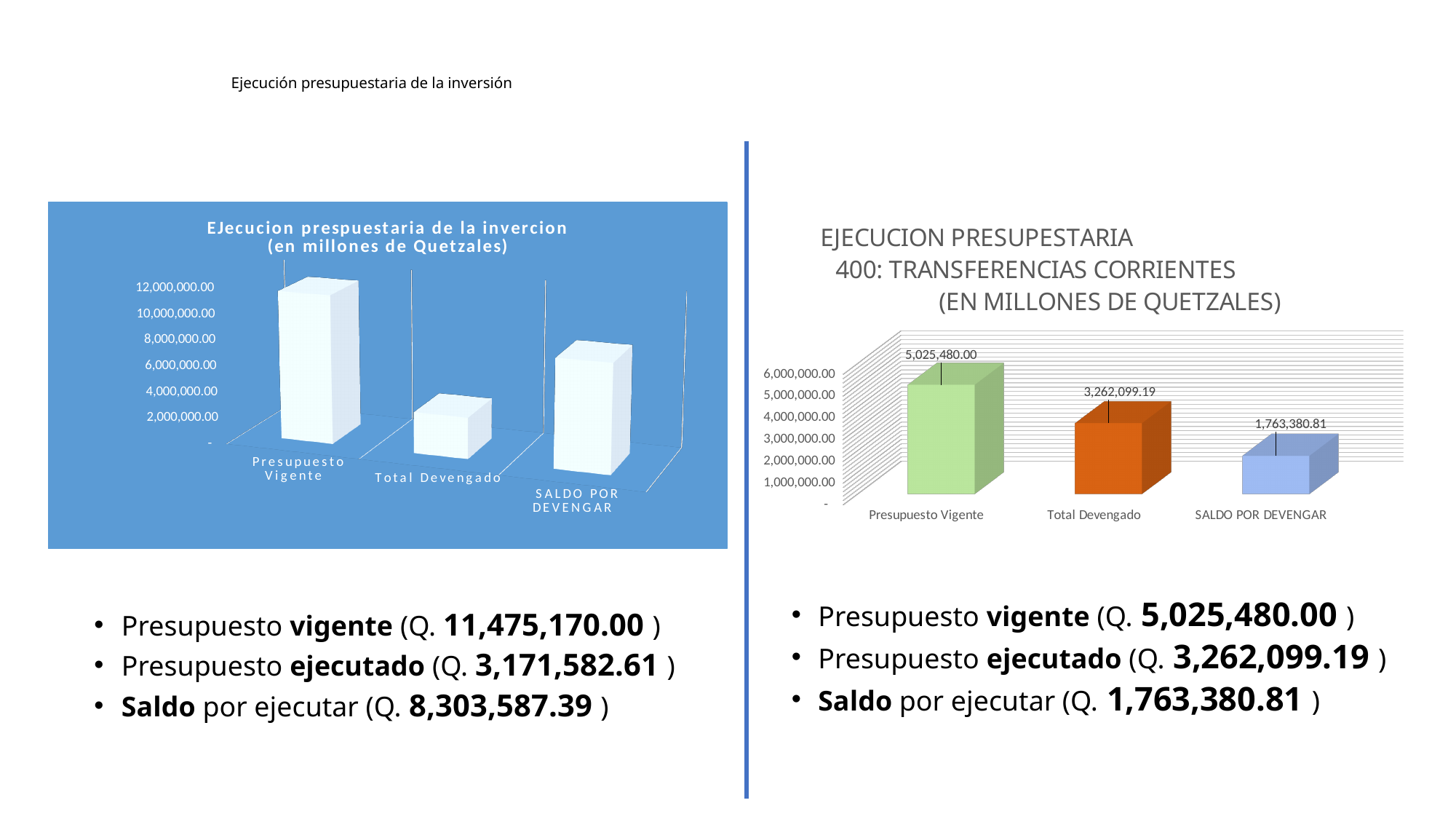
In the left chart (EJecucion prespuestaria de la invercion), is the value for Presupuesto Vigente greater or less than 10,000,000.00? greater In the right chart (EJECUCION PRESUPESTARIA 400: TRANSFERENCIAS CORRIENTES), what is the value for Presupuesto Vigente? 5,025,480.00 In the right chart (EJECUCION PRESUPESTARIA 400: TRANSFERENCIAS CORRIENTES), what is the value for SALDO POR DEVENGAR? 1,763,380.81 In the right chart (EJECUCION PRESUPESTARIA 400: TRANSFERENCIAS CORRIENTES), what is the value for Total Devengado? 3,262,099.19 In the left chart (EJecucion prespuestaria de la invercion), which category has the highest value? Presupuesto Vigente What kind of chart is the left chart (EJecucion prespuestaria de la invercion)? bar chart In the left chart (EJecucion prespuestaria de la invercion), how many categories are shown on the x axis? 3 In the right chart (EJECUCION PRESUPESTARIA 400: TRANSFERENCIAS CORRIENTES), which category has the lowest value? SALDO POR DEVENGAR In the right chart (EJECUCION PRESUPESTARIA 400: TRANSFERENCIAS CORRIENTES), do the values rise or fall from left to right along the x axis? fall In the left chart (EJecucion prespuestaria de la invercion), is the value for Total Devengado greater or less than 4,000,000.00? less In the right chart (EJECUCION PRESUPESTARIA 400: TRANSFERENCIAS CORRIENTES), what is the difference between Total Devengado and SALDO POR DEVENGAR? 1,498,718.38 In the right chart (EJECUCION PRESUPESTARIA 400: TRANSFERENCIAS CORRIENTES), what is the difference between Presupuesto Vigente and Total Devengado? 1,763,380.81